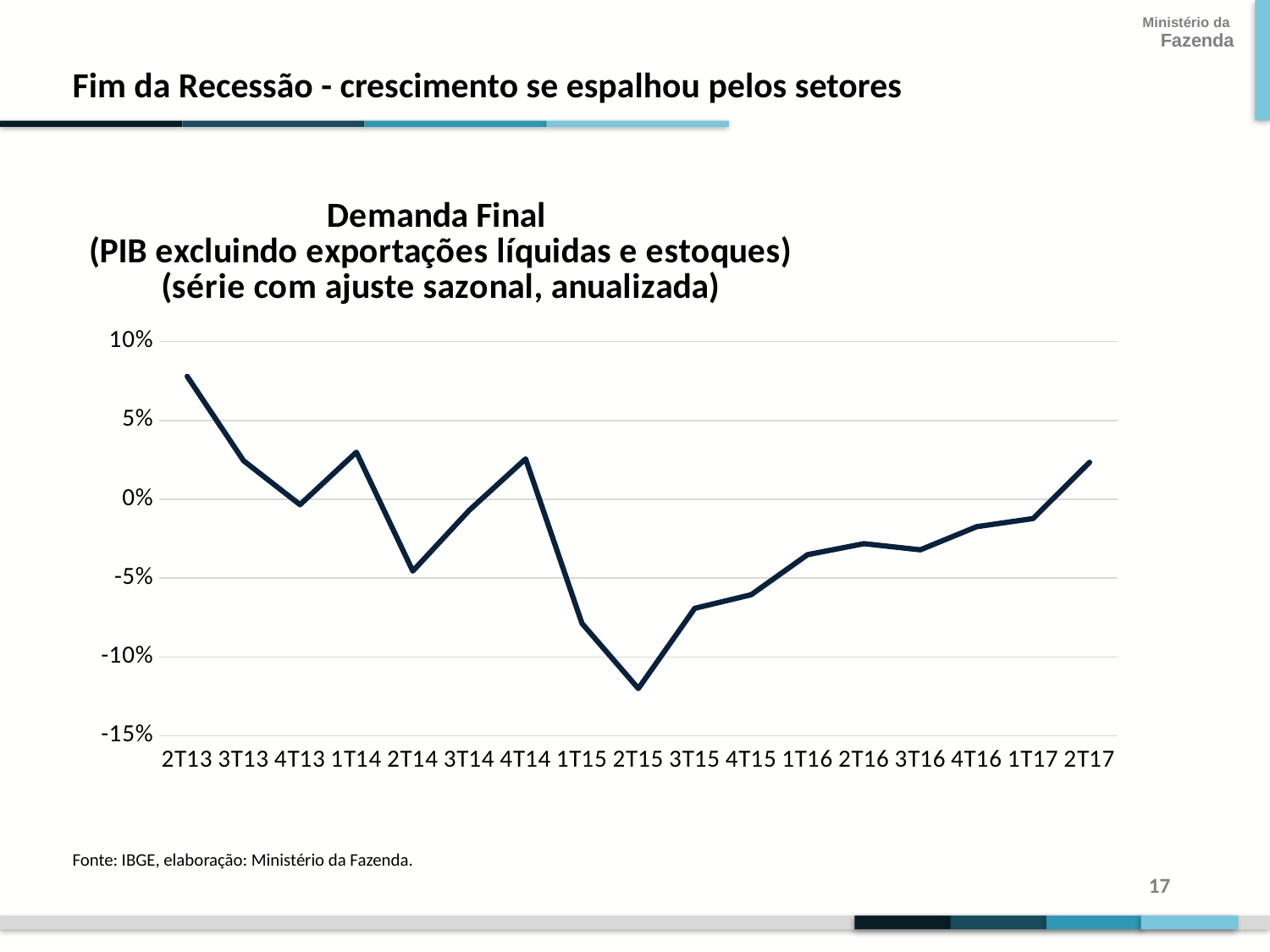
Is the value for 2T15 greater or less than -10%? less Do the values rise or fall from 2T15 to 2T17? rise Is the value for 2T17 greater or less than 0%? greater What is the first line of the chart title? Demanda Final Which quarter has the lowest value? 2T15 How many quarters are plotted along the x axis? 17 Is the value for 1T15 greater or less than -5%? less What kind of chart is shown on the slide? line chart Which is larger, the value for 1T14 or the value for 2T14? 1T14 Which is larger, the value for 4T15 or the value for 1T16? 1T16 Which quarter has the highest value? 2T13